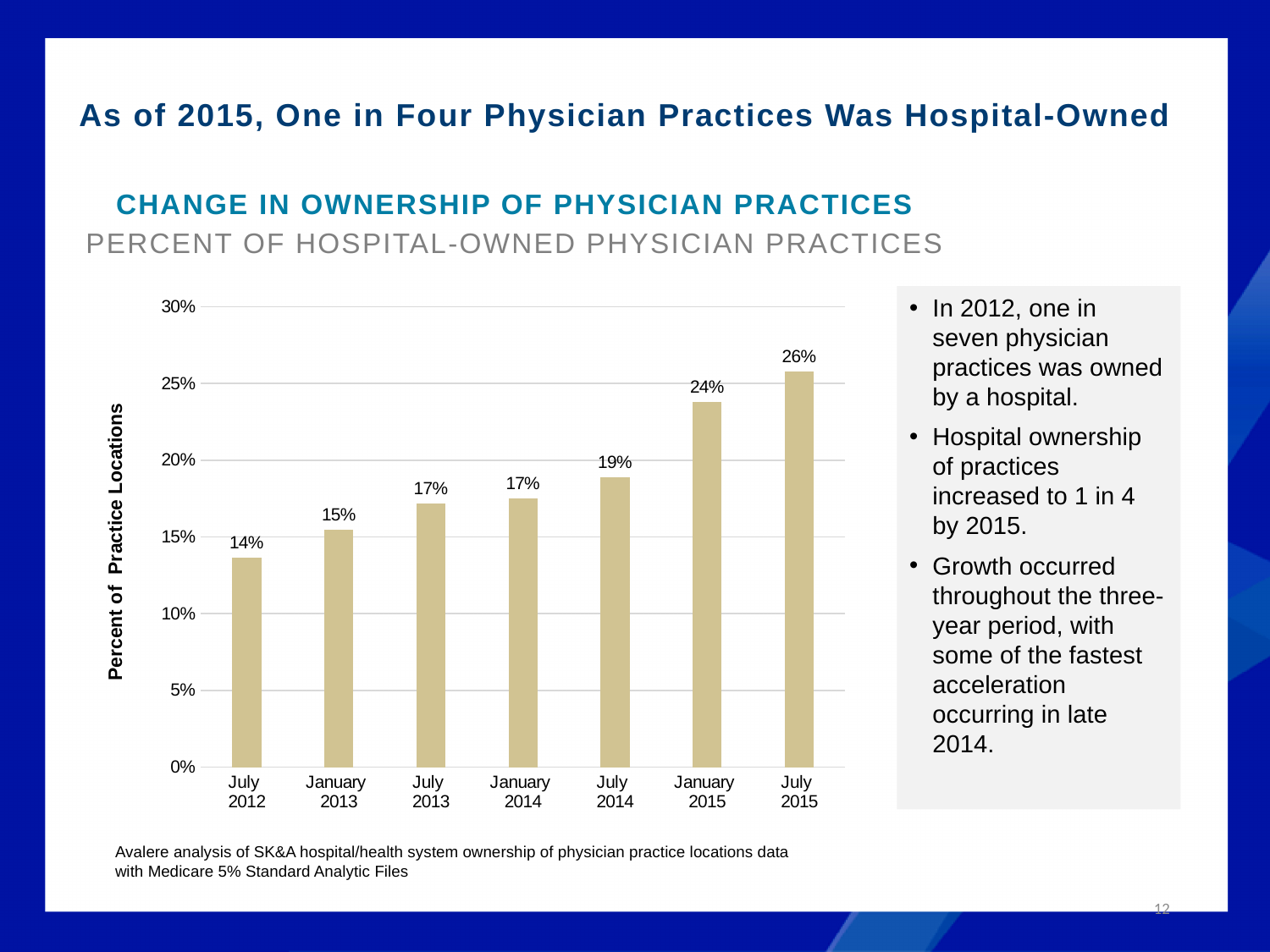
How many time periods are shown on the x axis? 7 Which period has the lowest percent of hospital-owned physician practices? July 2012 What is the difference in percentage points between July 2015 and July 2012? 12 Which period has the highest percent of hospital-owned physician practices? July 2015 Is the value for January 2015 greater or less than 20%? greater Do the values rise or fall from July 2012 to July 2015? Rise What is the percent of hospital-owned physician practices in July 2014? 19% What is the percent of hospital-owned physician practices in January 2015? 24% Which is larger, the value for January 2013 or the value for July 2014? July 2014 What is the percent of hospital-owned physician practices in July 2012? 14% What is the difference in percentage points between January 2015 and July 2014? 5 What kind of chart is shown on the slide? Bar chart